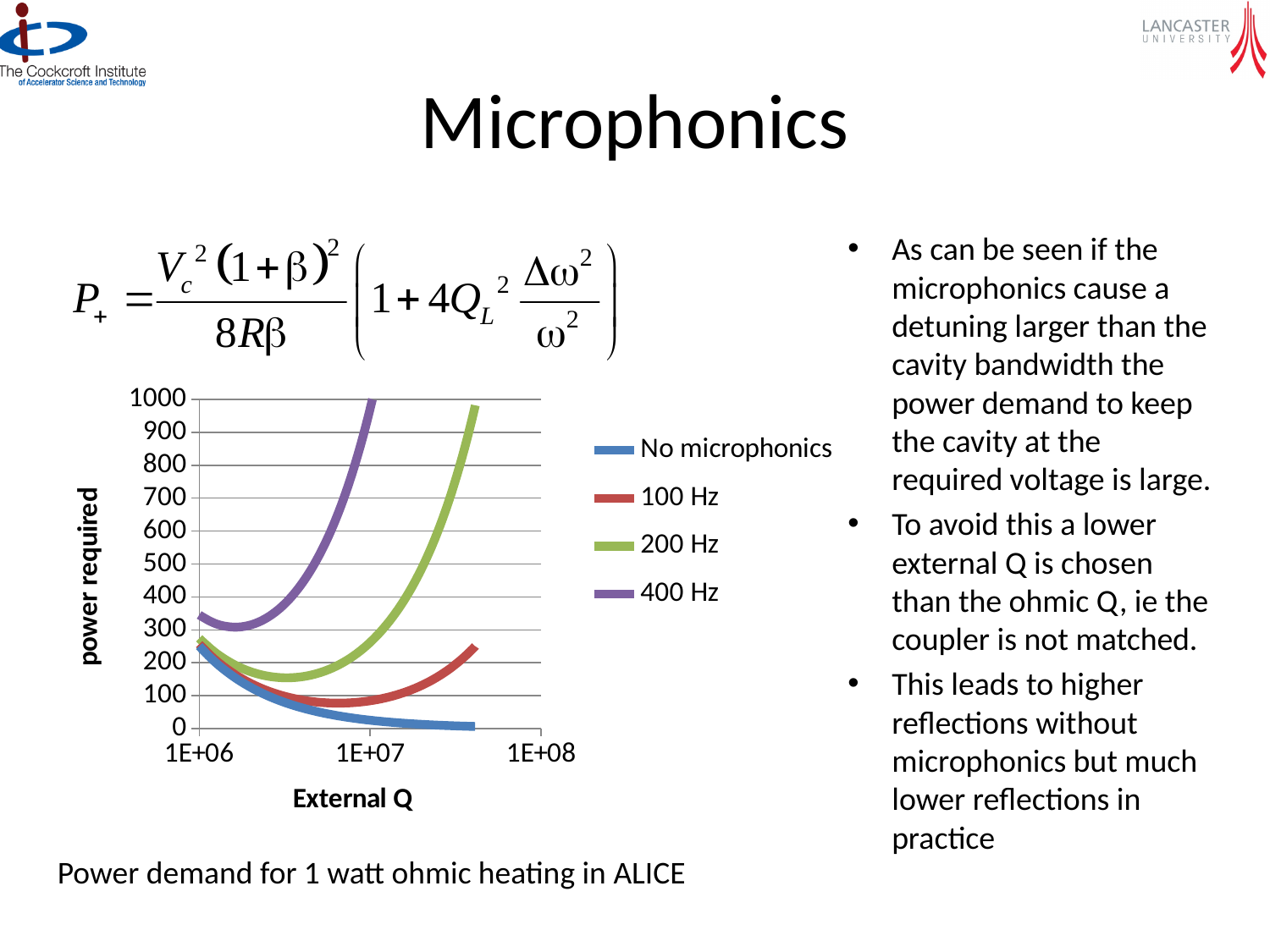
At an External Q of 1E+06, is the power required for the 400 Hz series greater or less than 300? greater What is the title of the y axis of the chart? power required Is the minimum power required for the 200 Hz series greater or less than 100? greater What kind of chart is shown on the slide? line chart At an External Q of 1E+06, which series has the larger power required: 400 Hz or No microphonics? 400 Hz Does the power required for the No microphonics series rise or fall as External Q increases? fall What is the title of the x axis of the chart? External Q Which series is drawn in blue on the chart? No microphonics How many series does the chart legend list? 4 At an External Q of 1E+07, is the power required for the No microphonics series greater or less than 100? less Which series reaches the highest power required values on the chart? 400 Hz Which series has the lowest power required at an External Q of 1E+07? No microphonics